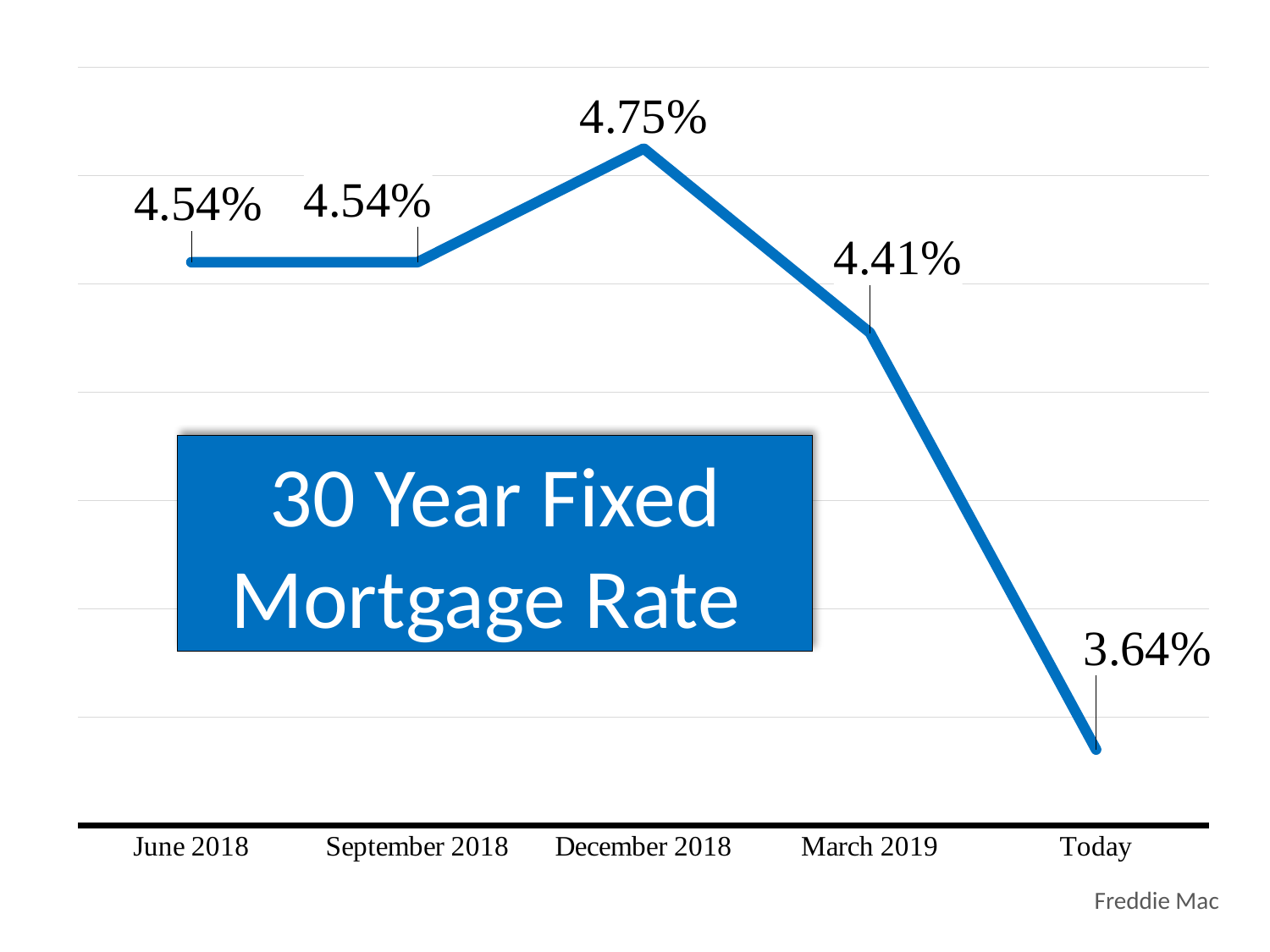
Which point on the chart has the highest mortgage rate? December 2018 Which point on the chart has the lowest mortgage rate? Today What was the mortgage rate in June 2018? 4.54% What was the mortgage rate in March 2019? 4.41% Which is higher, the rate in September 2018 or the rate in March 2019? September 2018 What is the difference between the December 2018 rate and the Today rate? 1.11% What is the title shown on the chart? 30 Year Fixed Mortgage Rate How many time points are plotted on the chart? 5 What kind of chart is shown on the slide? Line chart What is the difference between the March 2019 rate and the Today rate? 0.77% What is the mortgage rate shown for Today? 3.64% What was the 30 year fixed mortgage rate in December 2018? 4.75%